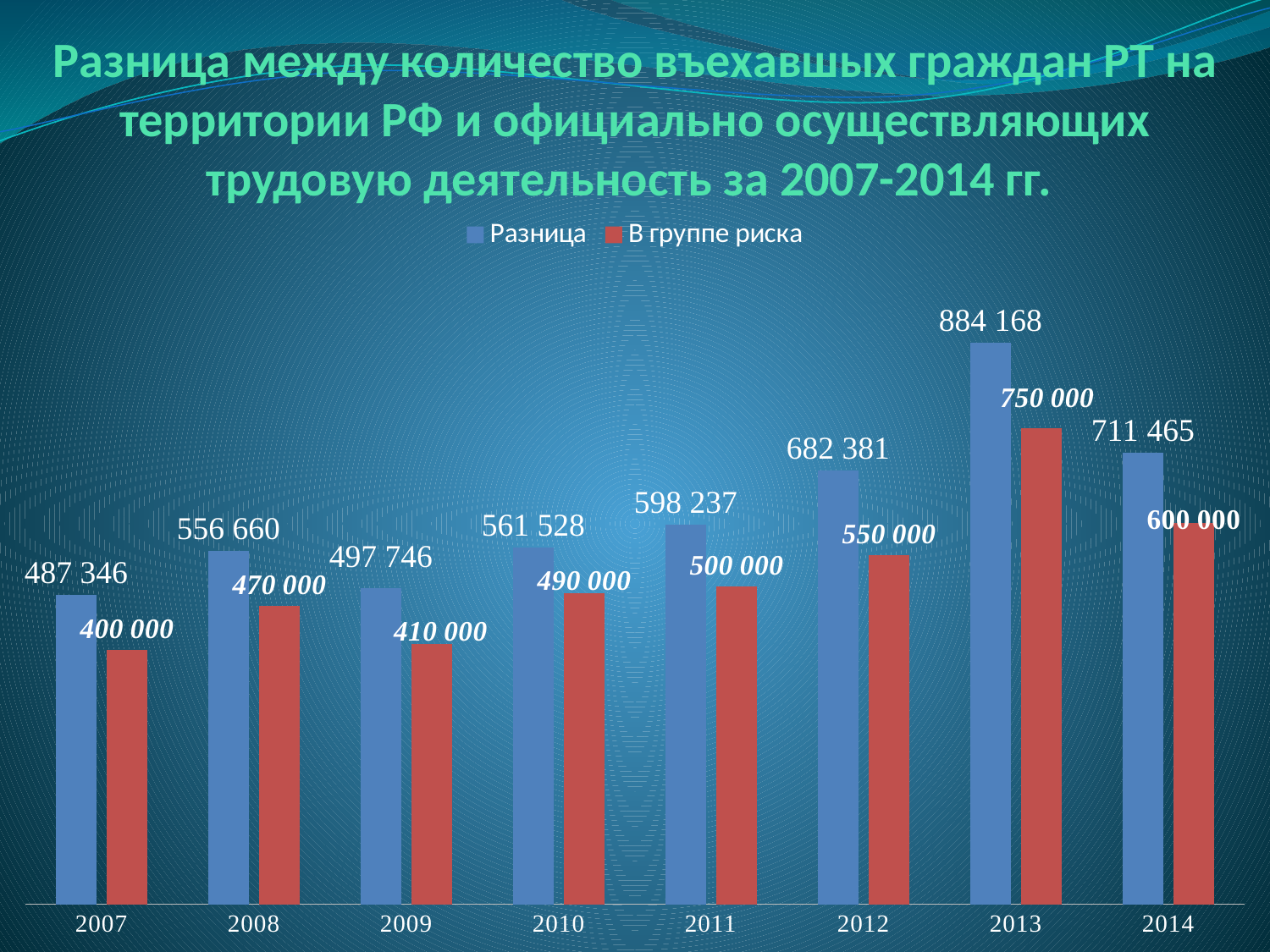
What is the difference between the "Разница" values for 2013 and 2012? 201 787 What is the value of "Разница" for 2013? 884 168 What type of chart is shown on the slide? bar chart How many series does the legend list? 2 What is the difference between "Разница" and "В группе риска" in 2013? 134 168 Which year has the highest value for "Разница"? 2013 Which series is shown in red in the legend? В группе риска How many years are shown on the x axis? 8 Which year has the lowest value for "В группе риска"? 2007 Which is larger: "Разница" in 2008 or "Разница" in 2009? 2008 What is the value of "Разница" for 2007? 487 346 What is the value of "В группе риска" for 2010? 490 000